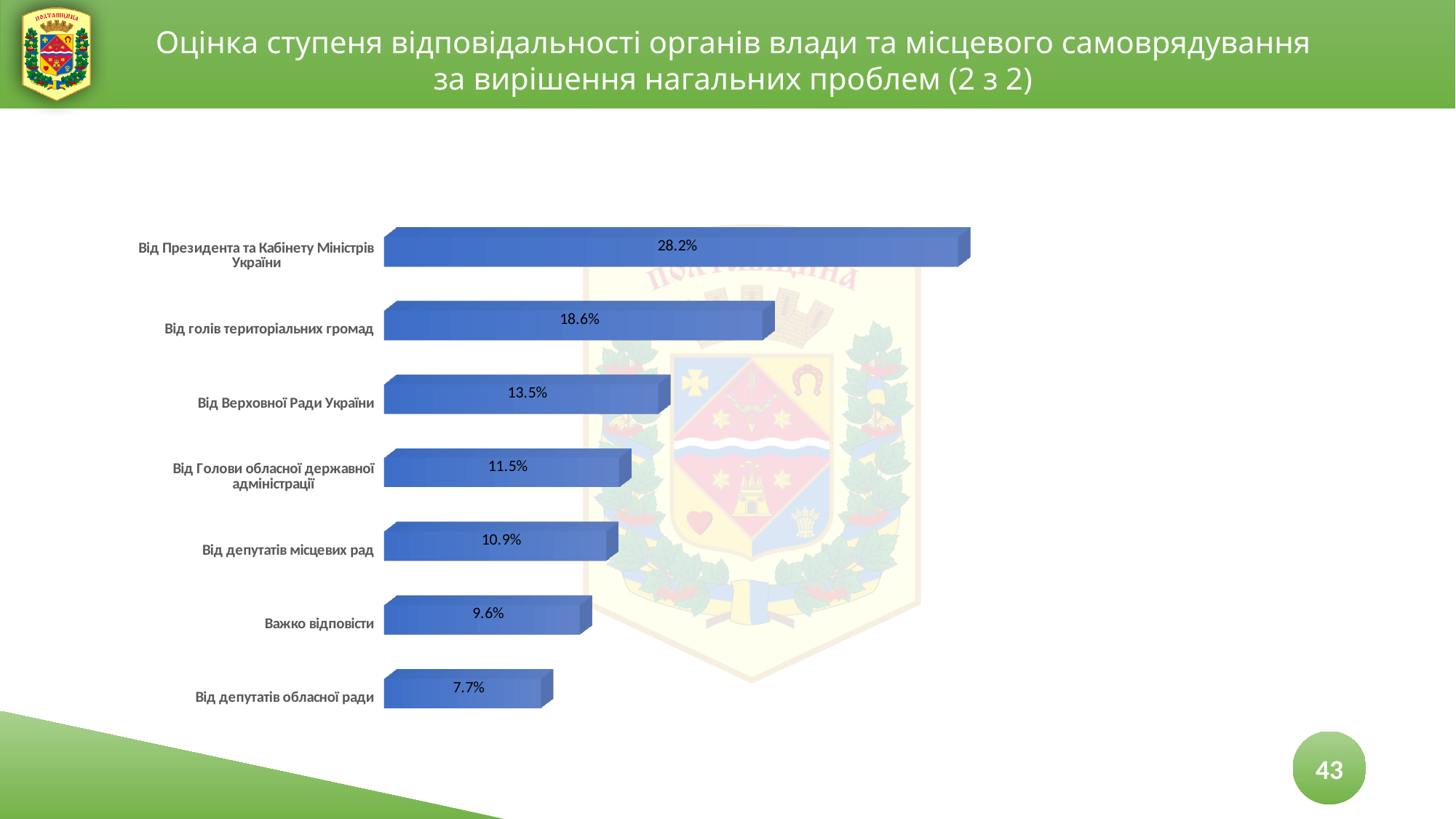
What is the difference between the values for "Від Голови обласної державної адміністрації" and "Від депутатів обласної ради"? 3.8% Which category has the highest value? Від Президента та Кабінету Міністрів України What is the value for "Важко відповісти"? 9.6% What is the difference between the values for "Від Президента та Кабінету Міністрів України" and "Від голів територіальних громад"? 9.6% What is the value for "Від Верховної Ради України"? 13.5% Which is larger: the value for "Від Верховної Ради України" or the value for "Від депутатів місцевих рад"? Від Верховної Ради України How many categories are shown in the chart? 7 Which category has the lowest value? Від депутатів обласної ради What is the slide title? Оцінка ступеня відповідальності органів влади та місцевого самоврядування за вирішення нагальних проблем (2 з 2) What kind of chart is shown on the slide? Bar chart What is the value for "Від Президента та Кабінету Міністрів України"? 28.2% What is the value for "Від голів територіальних громад"? 18.6%